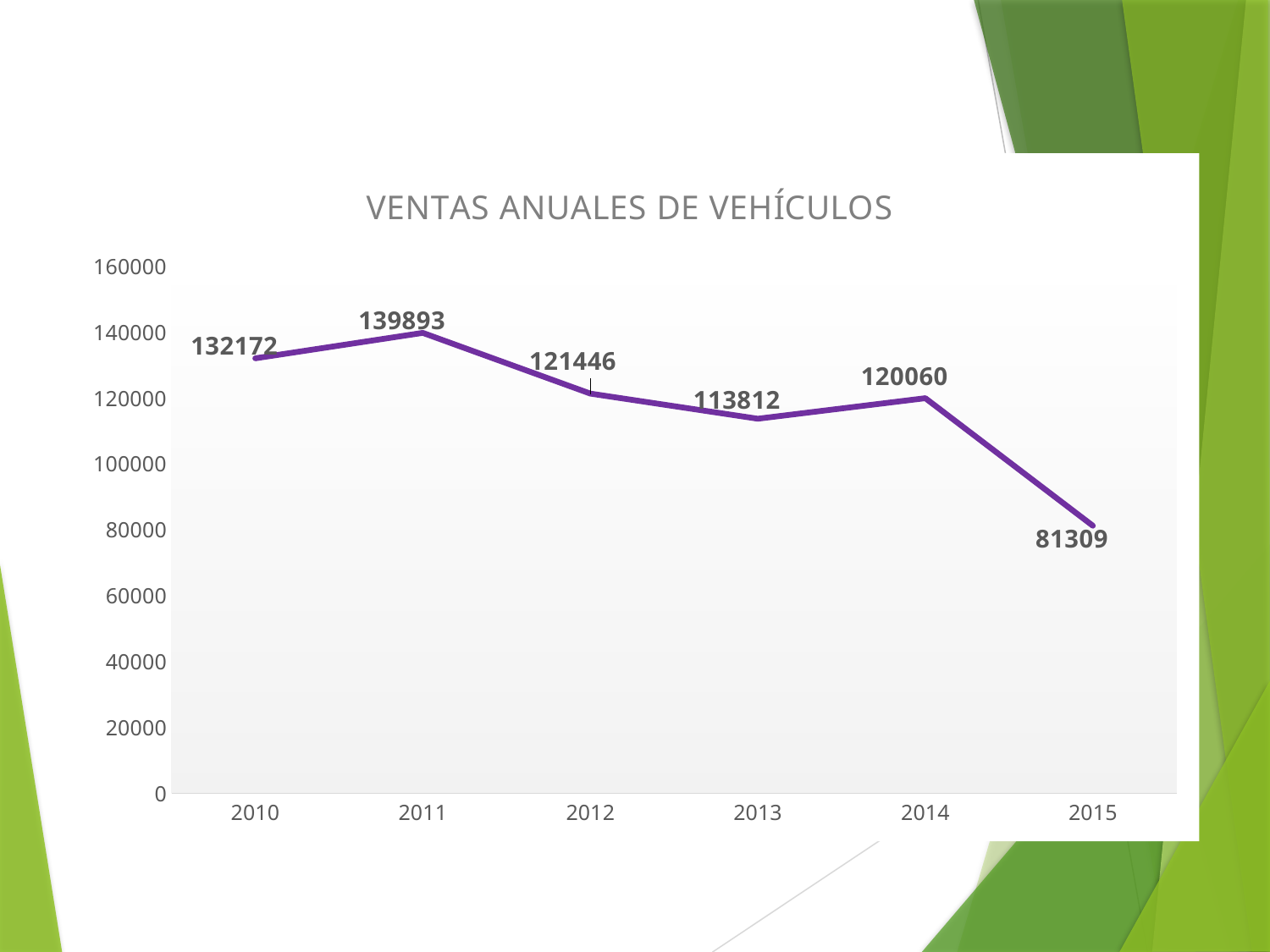
What is the value for 2015? 81309 Which year has the highest value? 2011 What is the value for 2010? 132172 Which year has the lowest value? 2015 Is the value for 2015 greater or less than 100000? less Which is larger, the value for 2012 or the value for 2014? 2012 What is the difference between the values for 2014 and 2015? 38751 What is the title of the chart? VENTAS ANUALES DE VEHÍCULOS How many years are plotted on the chart? 6 What is the value for 2013? 113812 What kind of chart is shown? line chart What is the difference between the values for 2011 and 2010? 7721